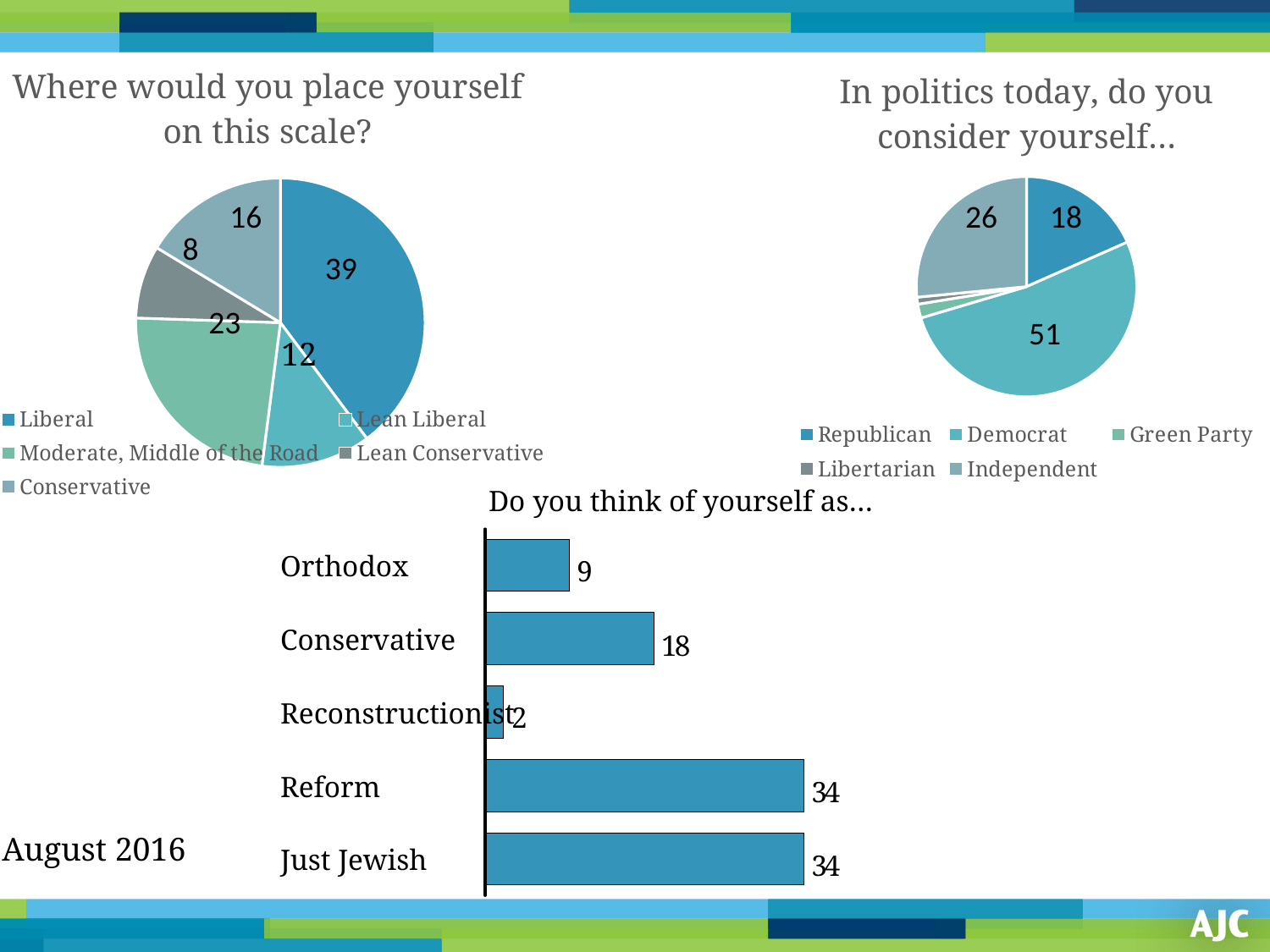
In the 'Do you think of yourself as...' bar chart, what is the difference between the Reform and Orthodox values? 25 In the 'Do you think of yourself as...' bar chart, what is the value for Conservative? 18 In the 'Do you think of yourself as...' bar chart, how many categories are shown? 5 In the 'In politics today, do you consider yourself...' pie chart, what is the difference between the Independent and Republican values? 8 In the 'Where would you place yourself on this scale?' pie chart, which category has the smallest slice? Lean Conservative What kind of chart is 'Do you think of yourself as...'? Bar chart In the 'Where would you place yourself on this scale?' pie chart, what value is shown for Liberal? 39 In the 'Do you think of yourself as...' bar chart, which category has the lowest value? Reconstructionist In the 'Where would you place yourself on this scale?' pie chart, how many categories does the legend list? 5 In the 'In politics today, do you consider yourself...' pie chart, which category has the largest slice? Democrat In the 'Where would you place yourself on this scale?' pie chart, what value is shown for Moderate, Middle of the Road? 23 In the 'In politics today, do you consider yourself...' pie chart, what value is shown for Democrat? 51